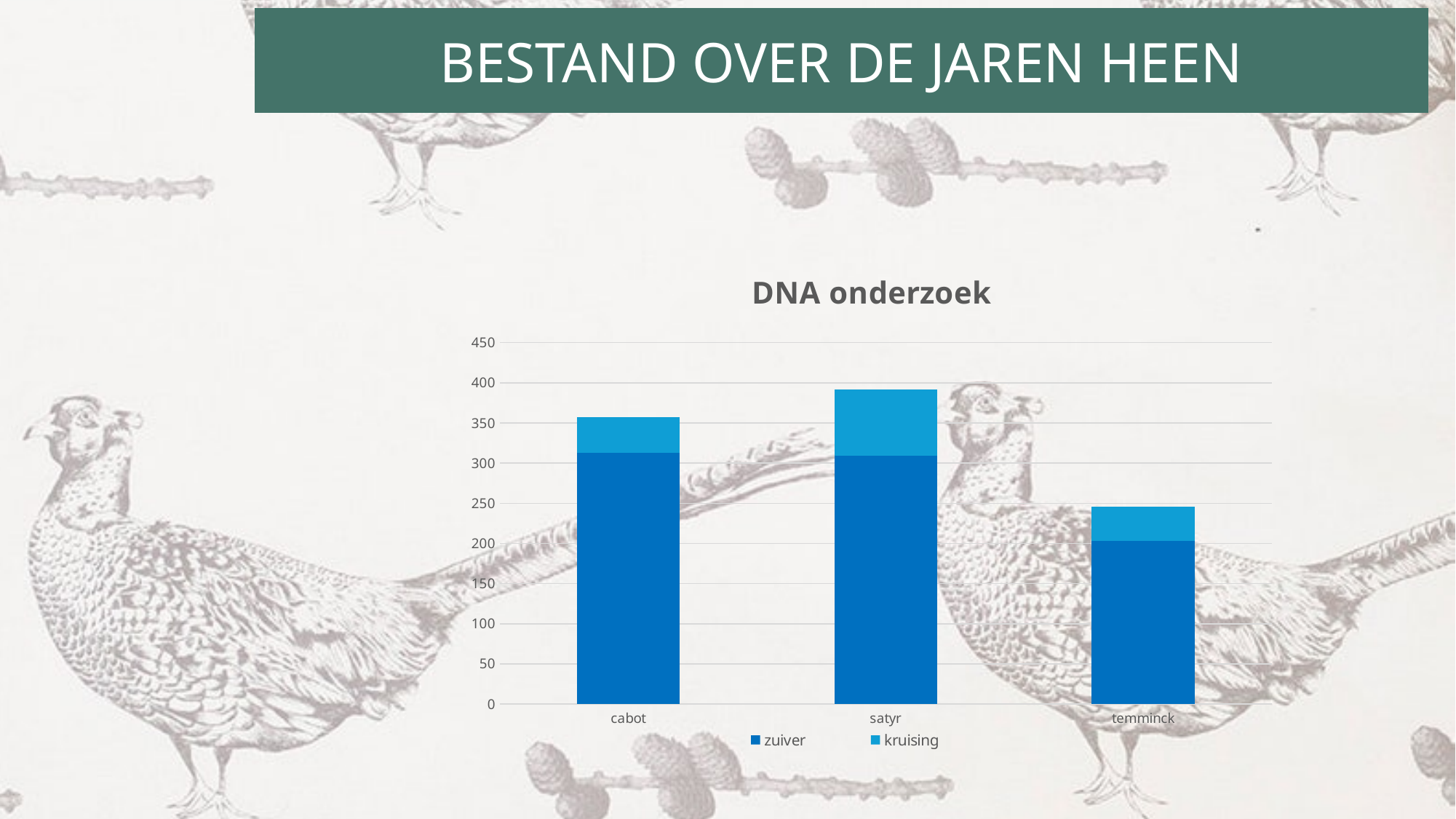
Which category has the shortest stacked bar in the chart? temminck Is the total stacked value for cabot greater or less than 400? less How many series does the legend of the chart list? 2 Is the total stacked value for temminck greater or less than 200? greater What is the title of the chart on the slide? DNA onderzoek How many categories are shown on the x axis of the chart? 3 Which has the larger zuiver value, cabot or temminck? cabot Is the total stacked value for satyr greater or less than 350? greater Which category has the tallest stacked bar in the chart? satyr What kind of chart is shown under the title "DNA onderzoek"? stacked bar chart Which series are listed in the legend of the chart? zuiver, kruising